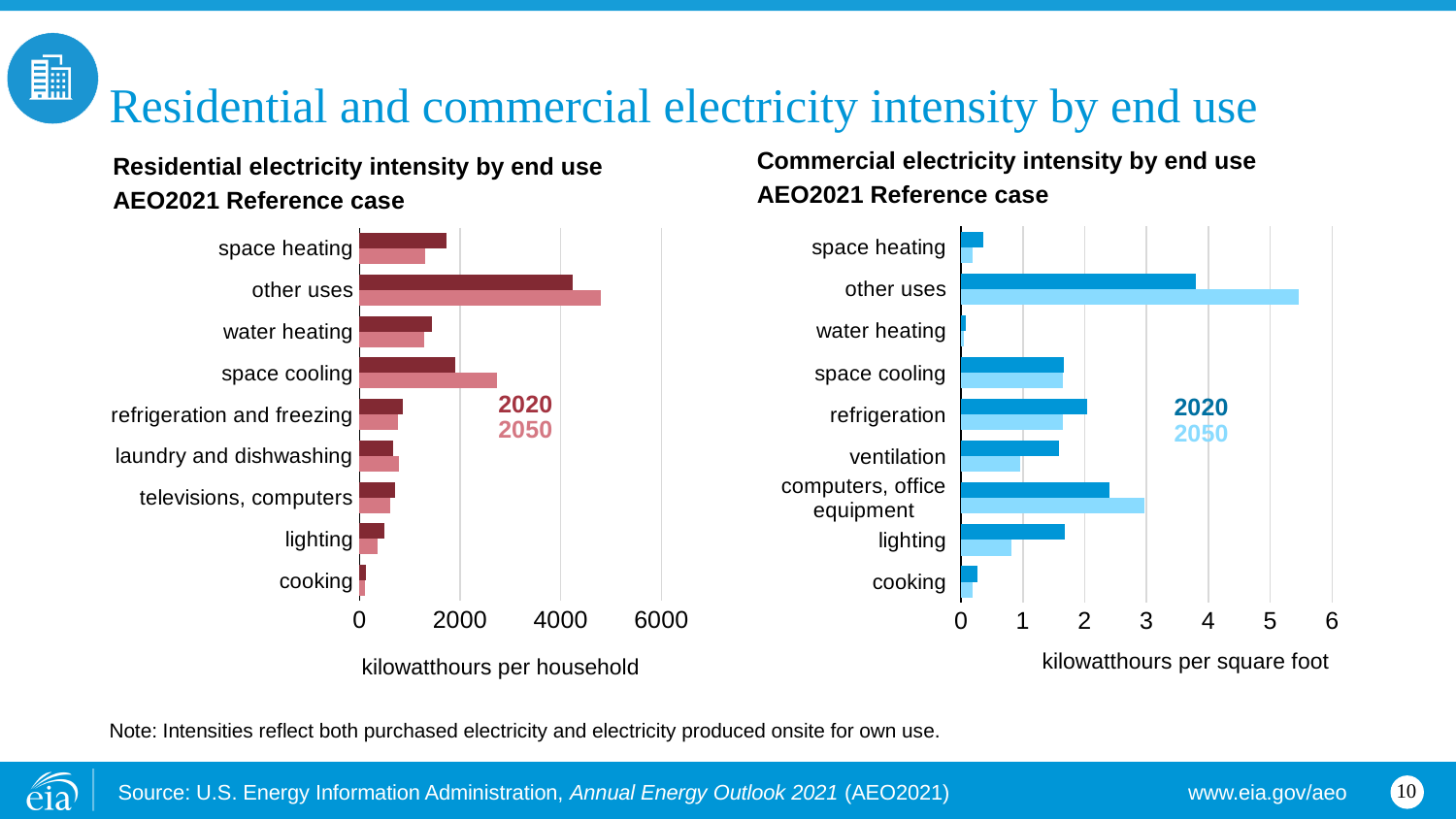
What unit is shown on the x axis of the commercial electricity intensity chart? kilowatthours per square foot How many series does the legend of the commercial electricity intensity chart list? 2 On the commercial electricity intensity chart, which end use has the highest value in 2050? other uses On the residential electricity intensity chart, is the 2050 value for space cooling greater or less than 2000 kilowatthours per household? greater On the commercial electricity intensity chart, which end use has the lowest value in 2020? water heating On the residential electricity intensity chart, which is larger for space heating: the 2020 value or the 2050 value? 2020 What kind of chart is the residential electricity intensity chart on the left? bar chart On the residential electricity intensity chart, which end use has the highest value in 2050? other uses On the residential electricity intensity chart, which end use has the lowest value in 2020? cooking On the commercial electricity intensity chart, which is larger for lighting: the 2020 value or the 2050 value? 2020 On the commercial electricity intensity chart, is the 2050 value for other uses greater or less than 5 kilowatthours per square foot? greater How many end-use categories are shown on the residential electricity intensity chart? 9